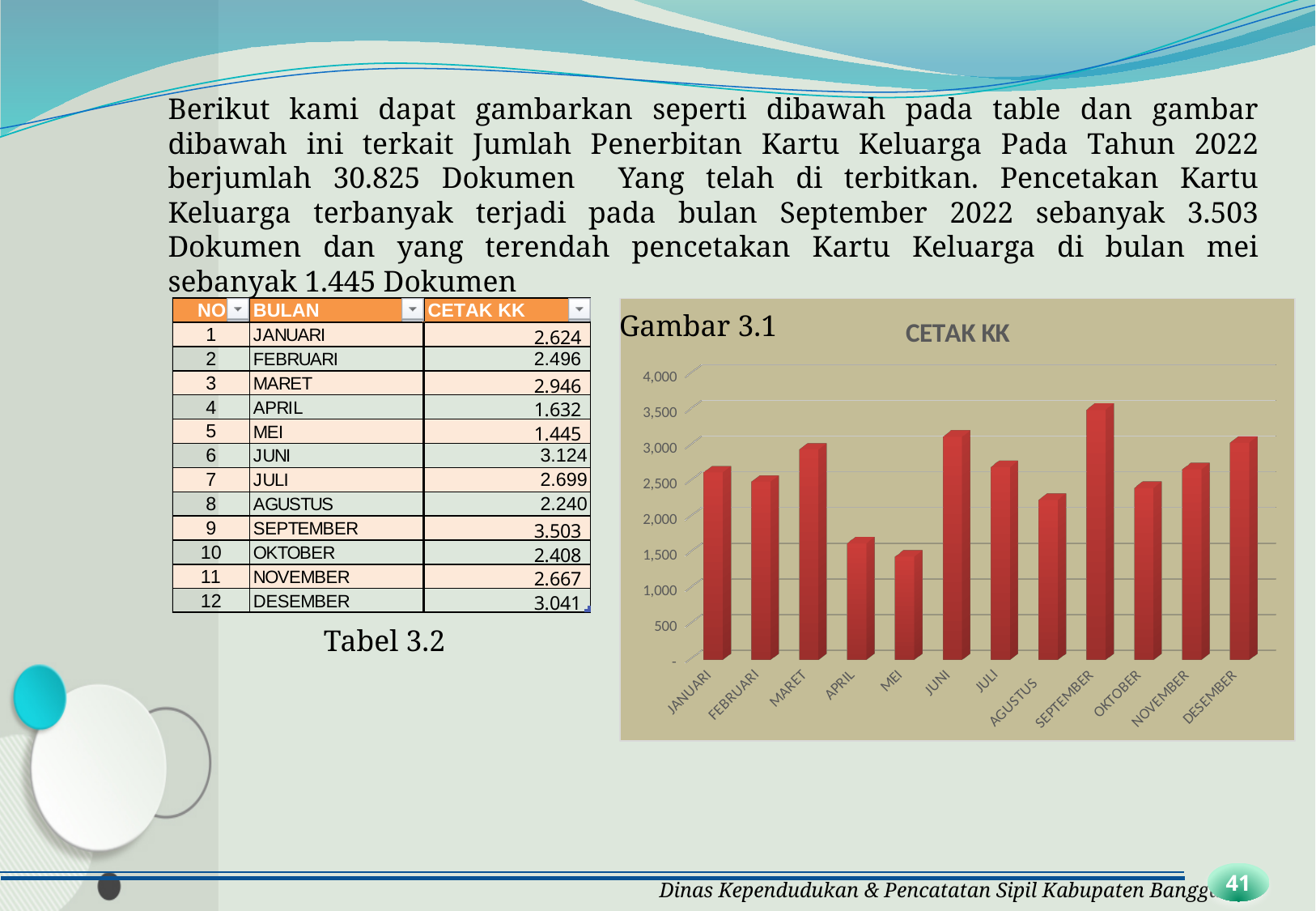
In the CETAK KK chart, is the value for AGUSTUS greater or less than 2,000? greater According to the slide, what is the CETAK KK value for SEPTEMBER? 3.503 What is the difference between the CETAK KK values for SEPTEMBER and MEI? 2.058 In the CETAK KK chart, is the value for APRIL greater or less than 2,000? less In the CETAK KK chart, is the bar for MARET or JULI taller? MARET In the CETAK KK chart, do the values rise or fall from APRIL to JUNI? rise How many months are plotted on the x axis of the CETAK KK chart? 12 According to the slide, what is the CETAK KK value for MEI? 1.445 Which month has the highest bar in the CETAK KK chart? SEPTEMBER What kind of chart is shown in Gambar 3.1? bar chart Which month has the lowest bar in the CETAK KK chart? MEI What is the title of the chart in Gambar 3.1? CETAK KK